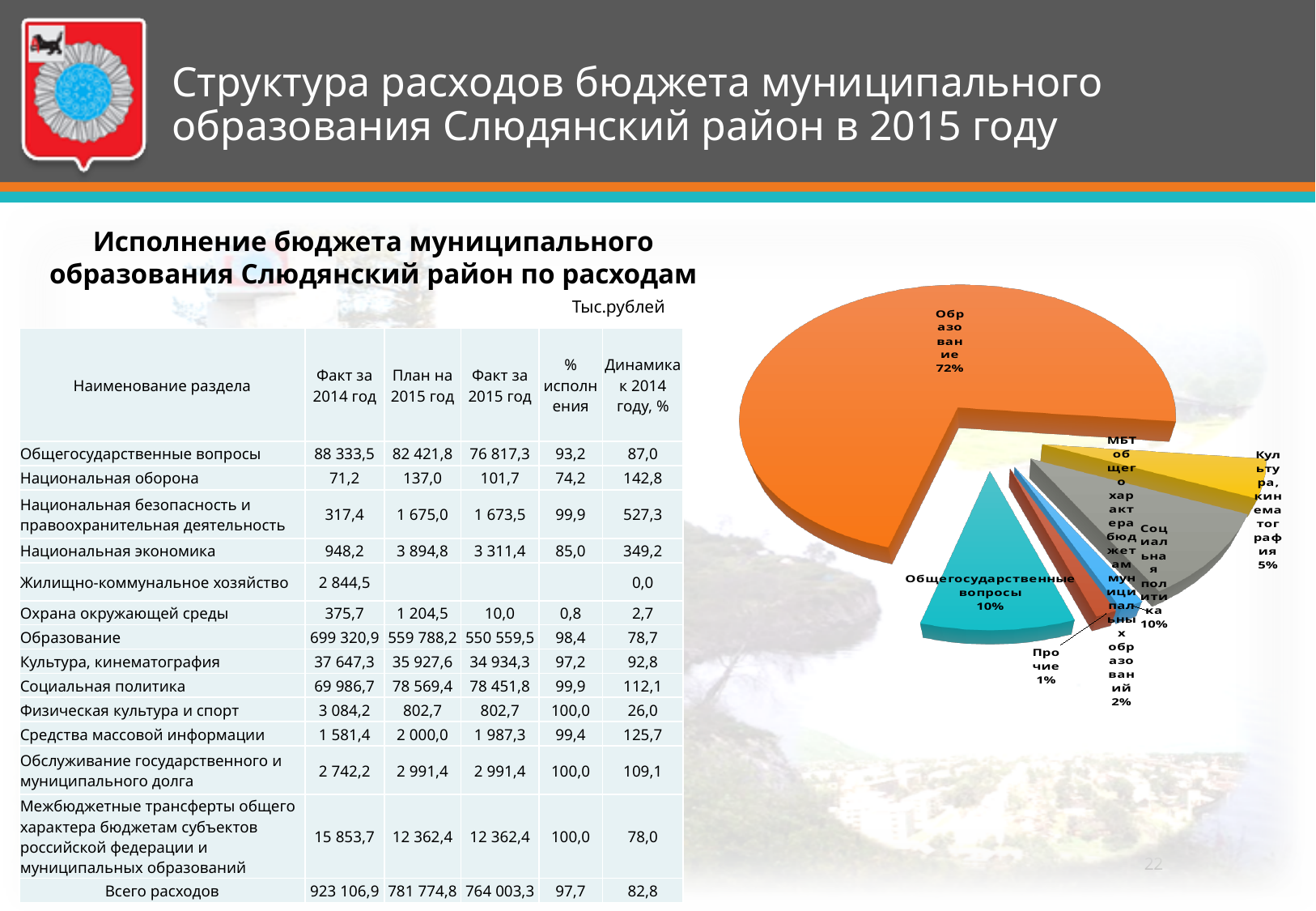
In the pie chart, what share does Социальная политика have? 10% In the pie chart, which is larger: Культура, кинематография or Прочие? Культура, кинематография Which slice of the pie chart is the largest? Образование Which slice of the pie chart is the smallest? Прочие What kind of chart is shown on the right side of the slide? pie chart In the pie chart, what share does Прочие have? 1% What colour is the Образование slice in the pie chart? orange How many slices does the pie chart have? 6 In the pie chart, what share does Культура, кинематография have? 5% In the pie chart, what is the difference in percentage points between Образование and Культура, кинематография? 67 In the pie chart, what share does Образование have? 72% In the pie chart, what share does Общегосударственные вопросы have? 10%